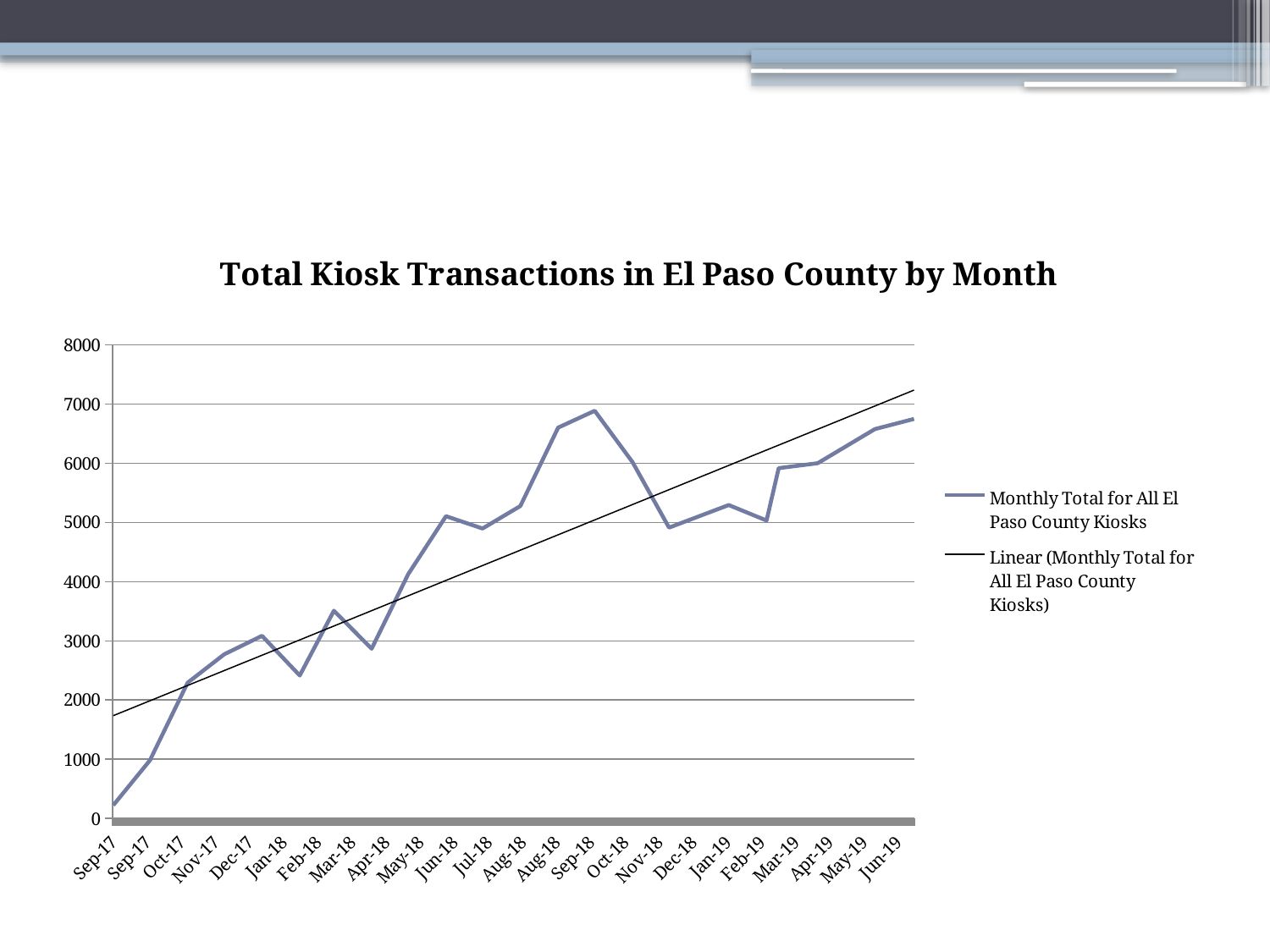
Which month has the lowest monthly total for all El Paso County kiosks? Sep-17 What is the title of the chart? Total Kiosk Transactions in El Paso County by Month Is the monthly total for Jun-19 greater or less than 6000? greater Is the monthly total for Sep-18 greater or less than 6000? greater Is the monthly total for Mar-18 greater or less than 3000? greater What kind of chart is shown on the slide? line chart Which is larger, the monthly total for Sep-18 or for Jan-18? Sep-18 Overall, do the monthly kiosk transaction totals rise or fall from Sep-17 to Jun-19? rise How many entries does the legend list? 2 How many month labels are shown along the x axis? 24